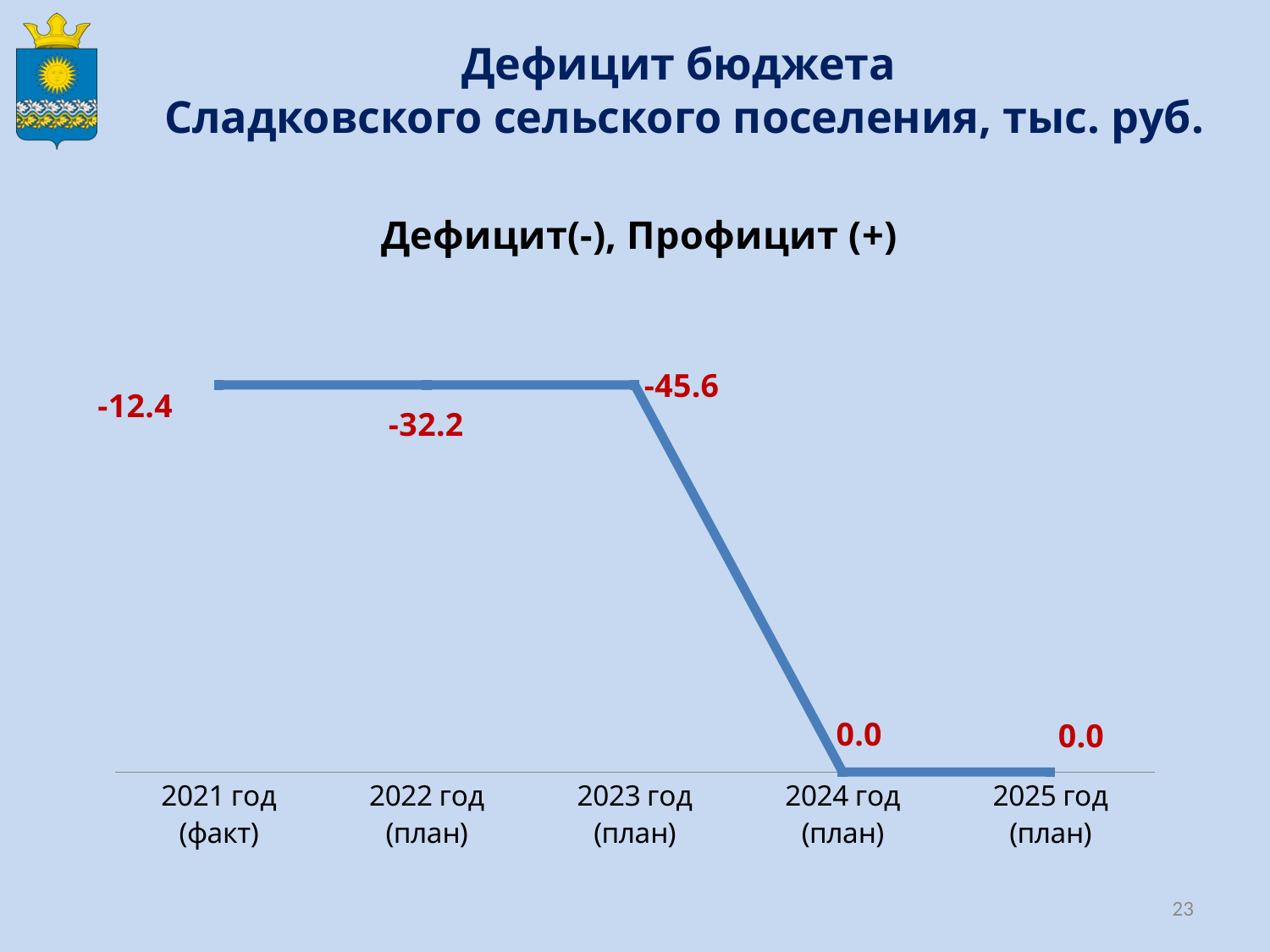
What kind of chart is shown on the slide? Line chart What is the difference between the values for 2021 год (факт) and 2022 год (план)? 19.8 What is the title of the chart? Дефицит(-), Профицит (+) What is the difference between the values for 2023 год (план) and 2022 год (план)? 13.4 What is the value for 2022 год (план)? -32.2 How many data points are plotted on the chart? 5 Which year has the lowest (most negative) value? 2023 год (план) What is the value for 2024 год (план)? 0.0 What is the value for 2025 год (план)? 0.0 What is the value for 2021 год (факт)? -12.4 What is the value for 2023 год (план)? -45.6 Which is larger, the value for 2021 год (факт) or the value for 2023 год (план)? 2021 год (факт)